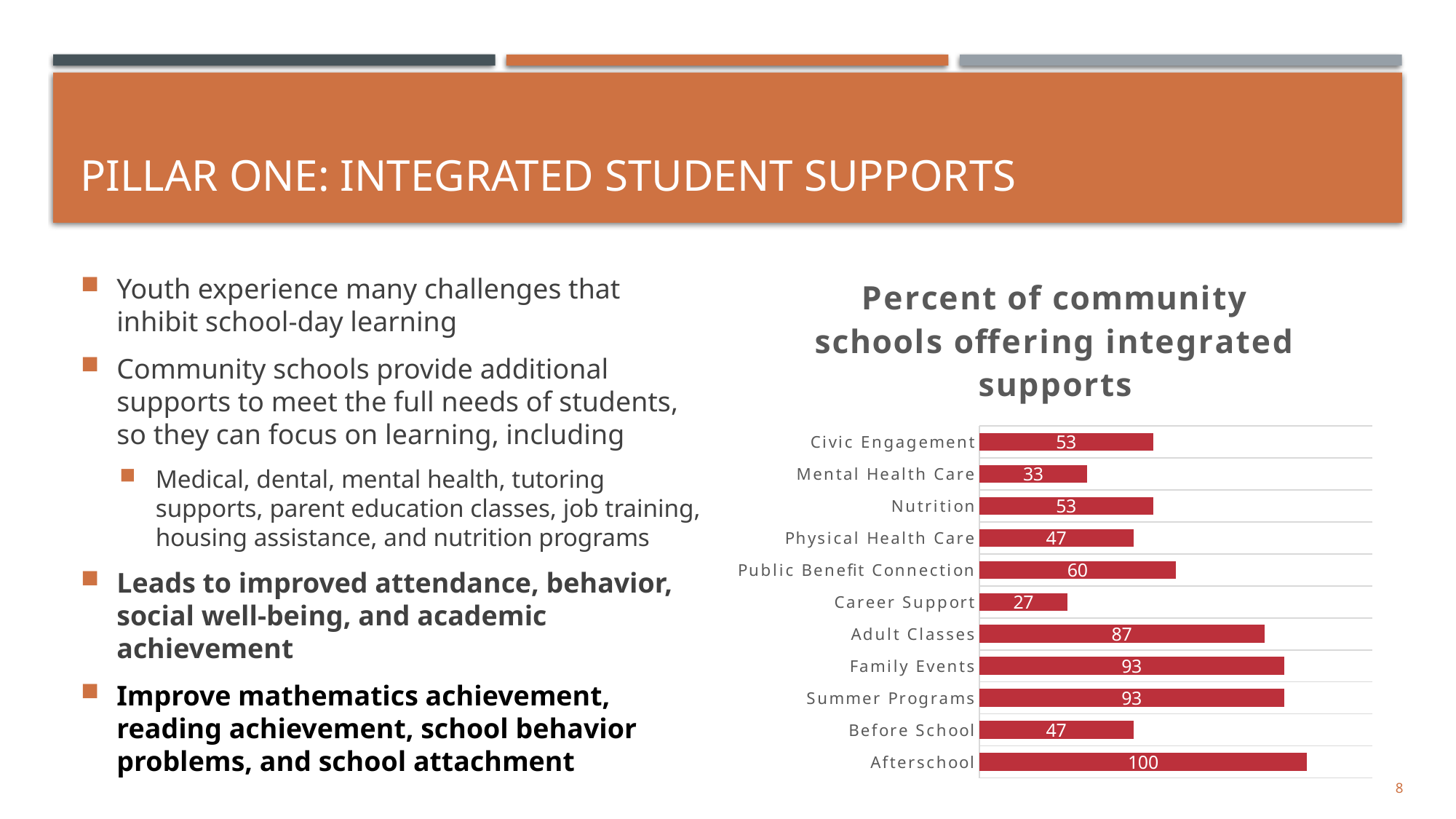
What is the difference between the values for Afterschool and Before School? 53 What is the value for Mental Health Care? 33 Which category has the lowest value? Career Support Which category has the highest value? Afterschool What is the difference between the values for Adult Classes and Physical Health Care? 40 What is the title of the chart? Percent of community schools offering integrated supports Which is larger, the value for Nutrition or the value for Mental Health Care? Nutrition How many categories are shown in the chart? 11 What is the value for Career Support? 27 What kind of chart is shown on the slide? Bar chart What is the value for Afterschool? 100 What is the value for Public Benefit Connection? 60